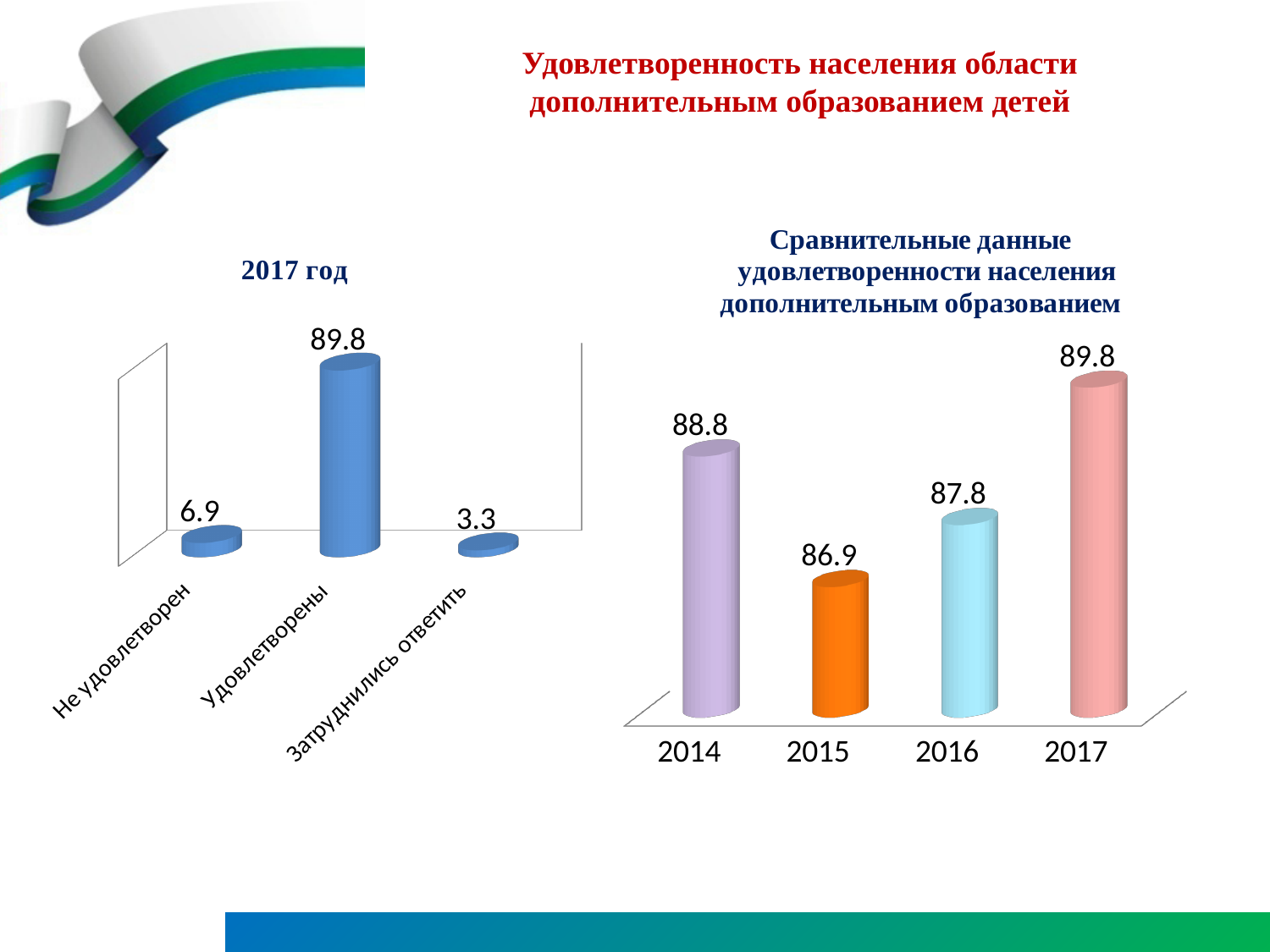
What type of chart is the right chart (Сравнительные данные удовлетворенности населения дополнительным образованием)? Bar chart In the right chart (Сравнительные данные удовлетворенности населения дополнительным образованием), what is the value for 2015? 86.9 In the right chart (Сравнительные данные удовлетворенности населения дополнительным образованием), which year has the highest value? 2017 In the left chart titled "2017 год", what is the value for "Удовлетворены"? 89.8 In the left chart titled "2017 год", what is the value for "Не удовлетворен"? 6.9 In the right chart (Сравнительные данные удовлетворенности населения дополнительным образованием), which is larger, the value for 2014 or the value for 2016? 2014 In the left chart titled "2017 год", how many categories are shown? 3 In the left chart titled "2017 год", which category has the lowest value? Затруднились ответить In the right chart (Сравнительные данные удовлетворенности населения дополнительным образованием), what is the difference between the 2017 and 2014 values? 1.0 In the right chart (Сравнительные данные удовлетворенности населения дополнительным образованием), what is the value for 2016? 87.8 In the left chart titled "2017 год", what is the difference between "Не удовлетворен" and "Затруднились ответить"? 3.6 In the right chart (Сравнительные данные удовлетворенности населения дополнительным образованием), which year has the lowest value? 2015